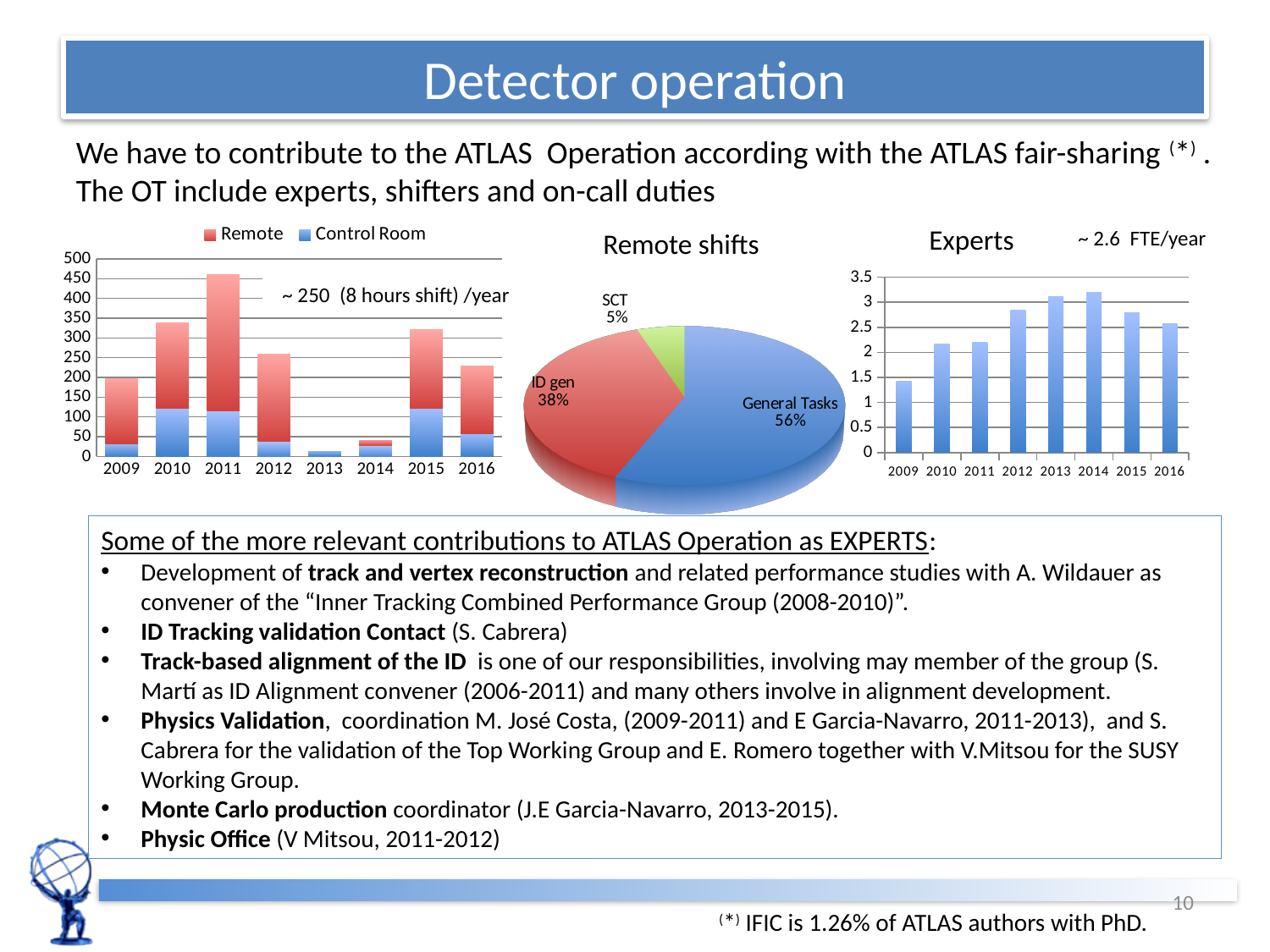
In the Experts chart, is the value for 2014 greater or less than 3? greater In the Remote shifts pie chart, which slice is the smallest? SCT In the Remote shifts pie chart, what share does General Tasks have? 56% In the left stacked bar chart, how many series does the legend list? 2 What kind of chart is the Experts chart? bar chart In the left stacked bar chart, which year has the highest total? 2011 In the Experts chart, which year has the lowest value? 2009 In the left stacked bar chart, which year has the lowest total? 2013 In the left stacked bar chart, is the total for 2011 greater or less than 400? greater In the left stacked bar chart, how many years are shown on the x axis? 8 In the left stacked bar chart, is the total for 2013 greater or less than 50? less In the Remote shifts pie chart, what share does ID gen have? 38%